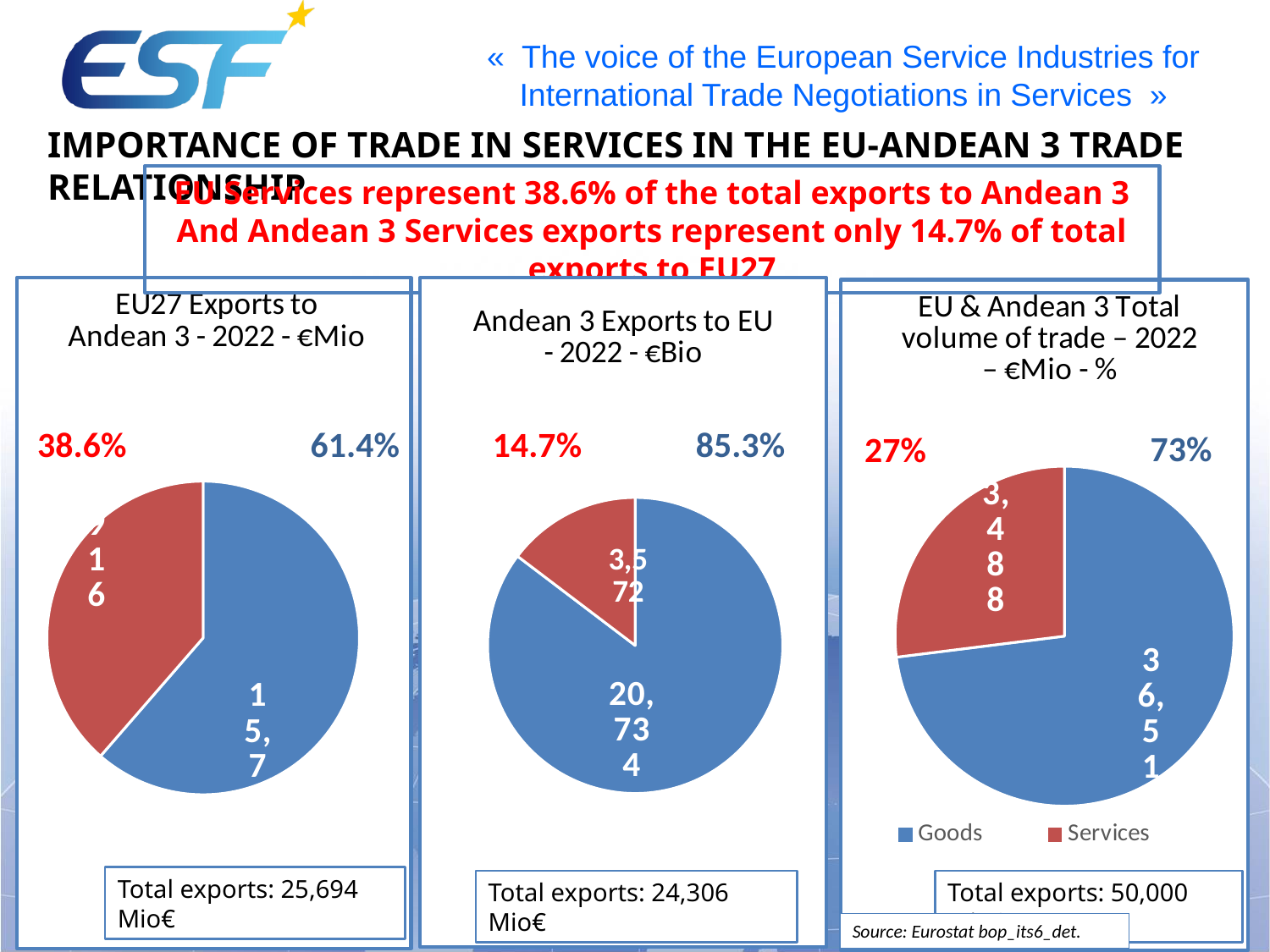
In the 'Andean 3 Exports to EU - 2022 - €Bio' chart, what is the difference between the Goods value and the Services value? 17,162 Is the Services share larger in the 'EU27 Exports to Andean 3' chart or in the 'Andean 3 Exports to EU' chart? EU27 Exports to Andean 3 In the 'Andean 3 Exports to EU - 2022 - €Bio' chart, what is the value labelled on the Services slice? 3,572 In the 'EU & Andean 3 Total volume of trade' chart, which category has the larger share, Goods or Services? Goods What total exports figure is shown below the 'EU27 Exports to Andean 3 - 2022 - €Mio' chart? 25,694 Mio€ In the 'Andean 3 Exports to EU - 2022 - €Bio' chart, what is the value labelled on the Goods slice? 20,734 How many entries does the legend on the 'EU & Andean 3 Total volume of trade' chart list? 2 What total exports figure is shown below the 'EU & Andean 3 Total volume of trade' chart? 50,000 In the 'Andean 3 Exports to EU - 2022 - €Bio' chart, what share of exports is Services? 14.7% What kind of chart is used on this slide for the 'EU27 Exports to Andean 3 - 2022 - €Mio' data? Pie chart In the 'EU27 Exports to Andean 3 - 2022 - €Mio' chart, what share of exports is Goods? 61.4% In the 'EU27 Exports to Andean 3 - 2022 - €Mio' chart, what share of exports is Services? 38.6%